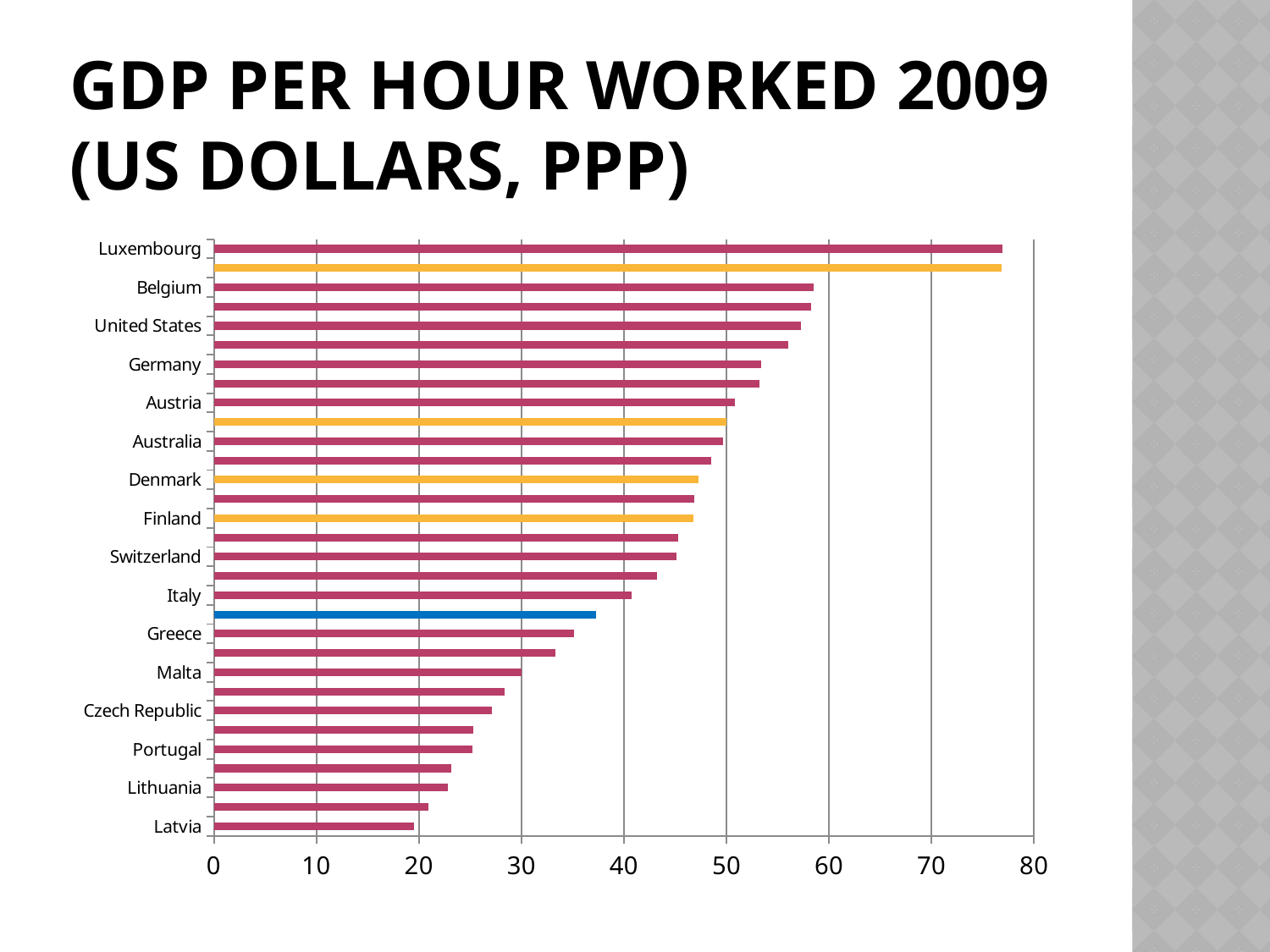
What is the title of the chart? GDP PER HOUR WORKED 2009 (US DOLLARS, PPP) Which labelled country has the lowest GDP per hour worked in the chart? Latvia Which has a higher GDP per hour worked, Germany or Portugal? Germany Is the value for Belgium greater or less than 50? greater Is the value for Denmark greater or less than 50? less Is the value for Greece greater or less than 40? less What kind of chart is shown on the slide? bar chart Do the bar values increase or decrease going from the top of the chart to the bottom? decrease Which country has the highest GDP per hour worked in the chart? Luxembourg